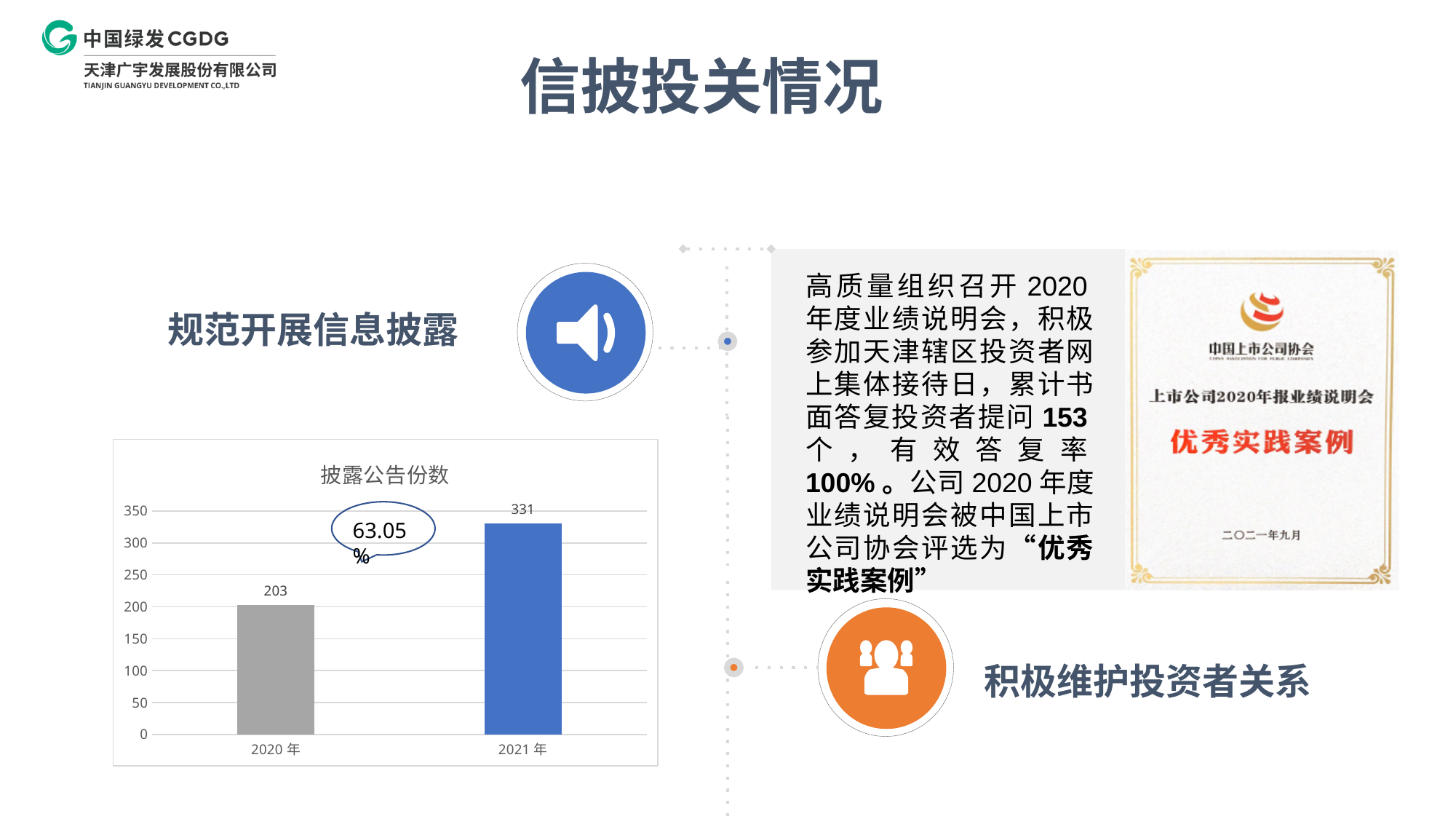
Is the value for 2021 年 greater or less than 300? greater What is the value for 2021 年 in the chart? 331 Do the values rise or fall from 2020 年 to 2021 年? rise What is the value for 2020 年 in the chart? 203 What percentage is written in the circled annotation between the two bars? 63.05% Which year has the higher value in the chart? 2021 年 What is the title of the chart on the slide? 披露公告份数 Which year has the lower value in the chart? 2020 年 How many categories are shown on the x axis of the chart? 2 Is the value for 2020 年 greater or less than 250? less What is the difference between the values for 2021 年 and 2020 年? 128 What type of chart is shown on the slide? bar chart